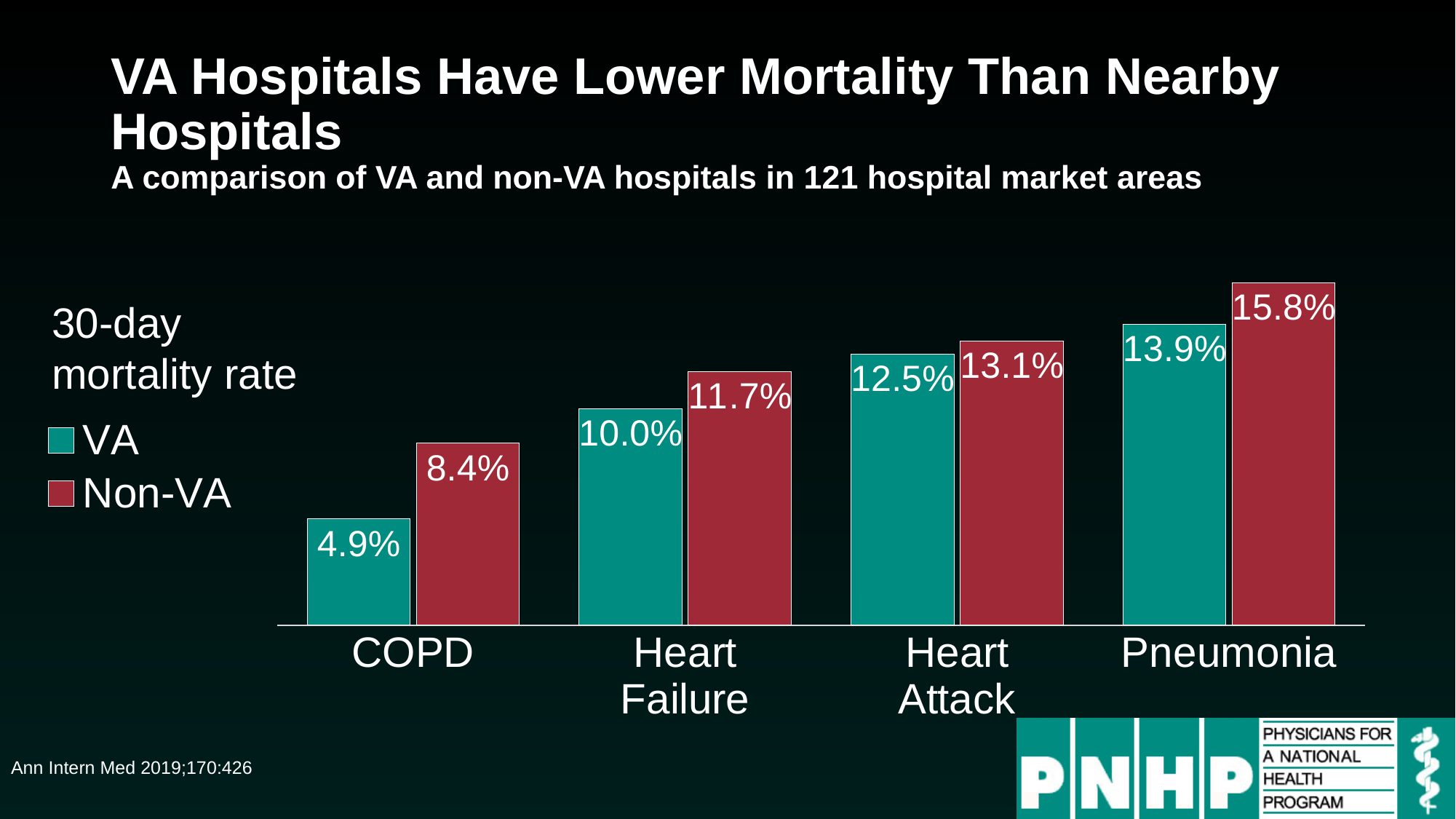
Which is larger for Heart Failure, the VA or the Non-VA mortality rate? Non-VA Which condition has the lowest Non-VA 30-day mortality rate? COPD How many conditions are shown on the x axis? 4 What is the 30-day mortality rate for Non-VA hospitals for Pneumonia? 15.8% What is the 30-day mortality rate for VA hospitals for Heart Attack? 12.5% What is the difference between the Non-VA and VA mortality rates for COPD? 3.5% What is the 30-day mortality rate for VA hospitals for COPD? 4.9% What is the difference between the Non-VA and VA mortality rates for Pneumonia? 1.9% Which condition has the highest VA 30-day mortality rate? Pneumonia What kind of chart is shown on the slide? Bar chart How many series does the legend list? 2 What is the 30-day mortality rate for Non-VA hospitals for Heart Failure? 11.7%